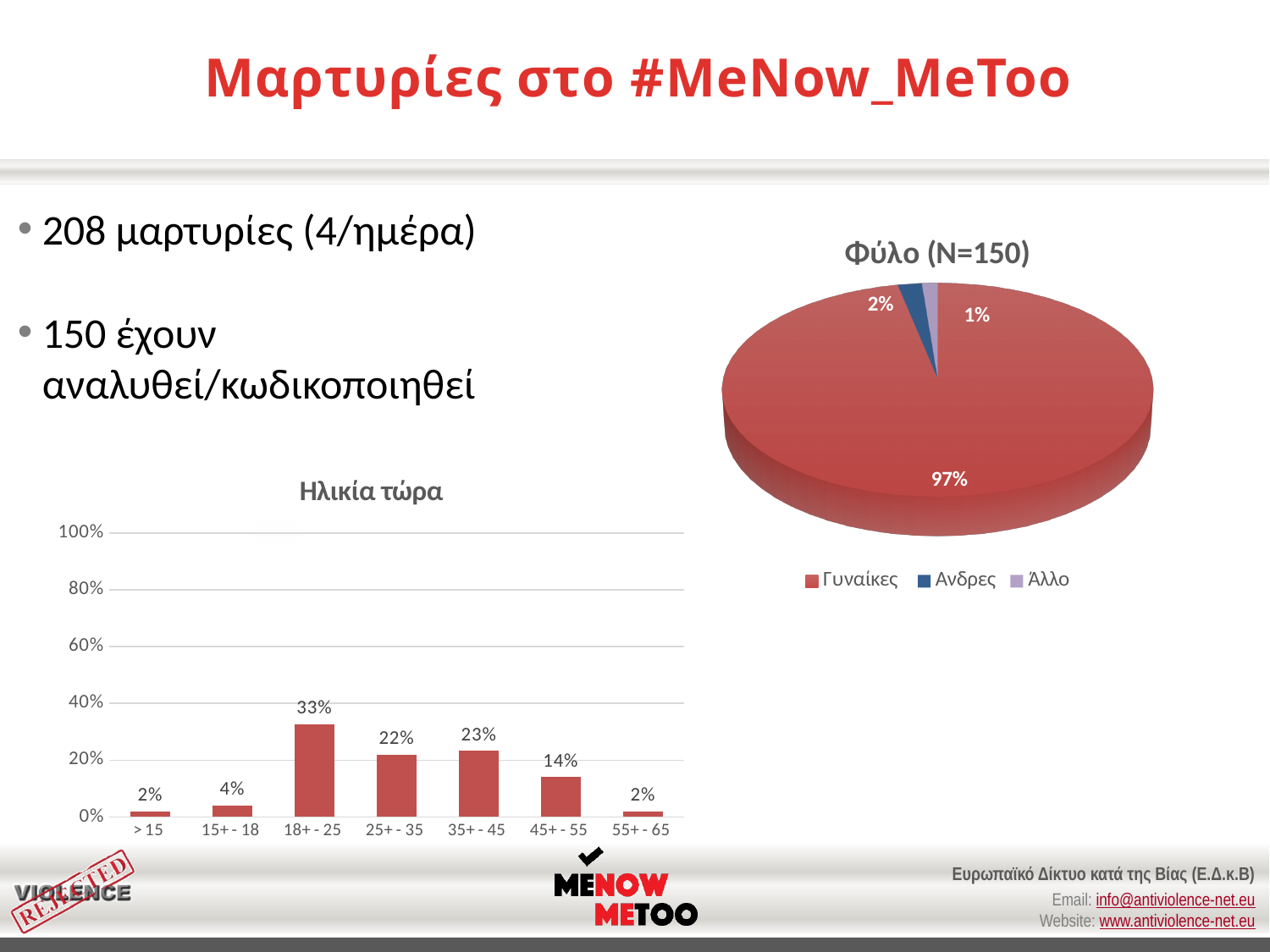
In the 'Ηλικία τώρα' chart, what is the value for the 45+ - 55 category? 14% In the 'Ηλικία τώρα' chart, what is the value for the 18+ - 25 category? 33% What kind of chart is 'Φύλο (N=150)'? Pie chart In the 'Ηλικία τώρα' chart, which is larger, the value for 35+ - 45 or the value for 45+ - 55? 35+ - 45 In the 'Ηλικία τώρα' chart, is the value for 18+ - 25 greater or less than 40%? less In the 'Φύλο (N=150)' pie chart, what share is labelled for Γυναίκες? 97% In the 'Φύλο (N=150)' pie chart, what share is labelled for Ανδρες? 2% In the 'Ηλικία τώρα' chart, how many age categories are shown on the x axis? 7 In the 'Ηλικία τώρα' chart, what is the difference between the values for 18+ - 25 and 25+ - 35? 11% How many entries does the legend of the 'Φύλο (N=150)' pie chart list? 3 What kind of chart is 'Ηλικία τώρα'? Bar chart In the 'Ηλικία τώρα' chart, which age category has the highest value? 18+ - 25